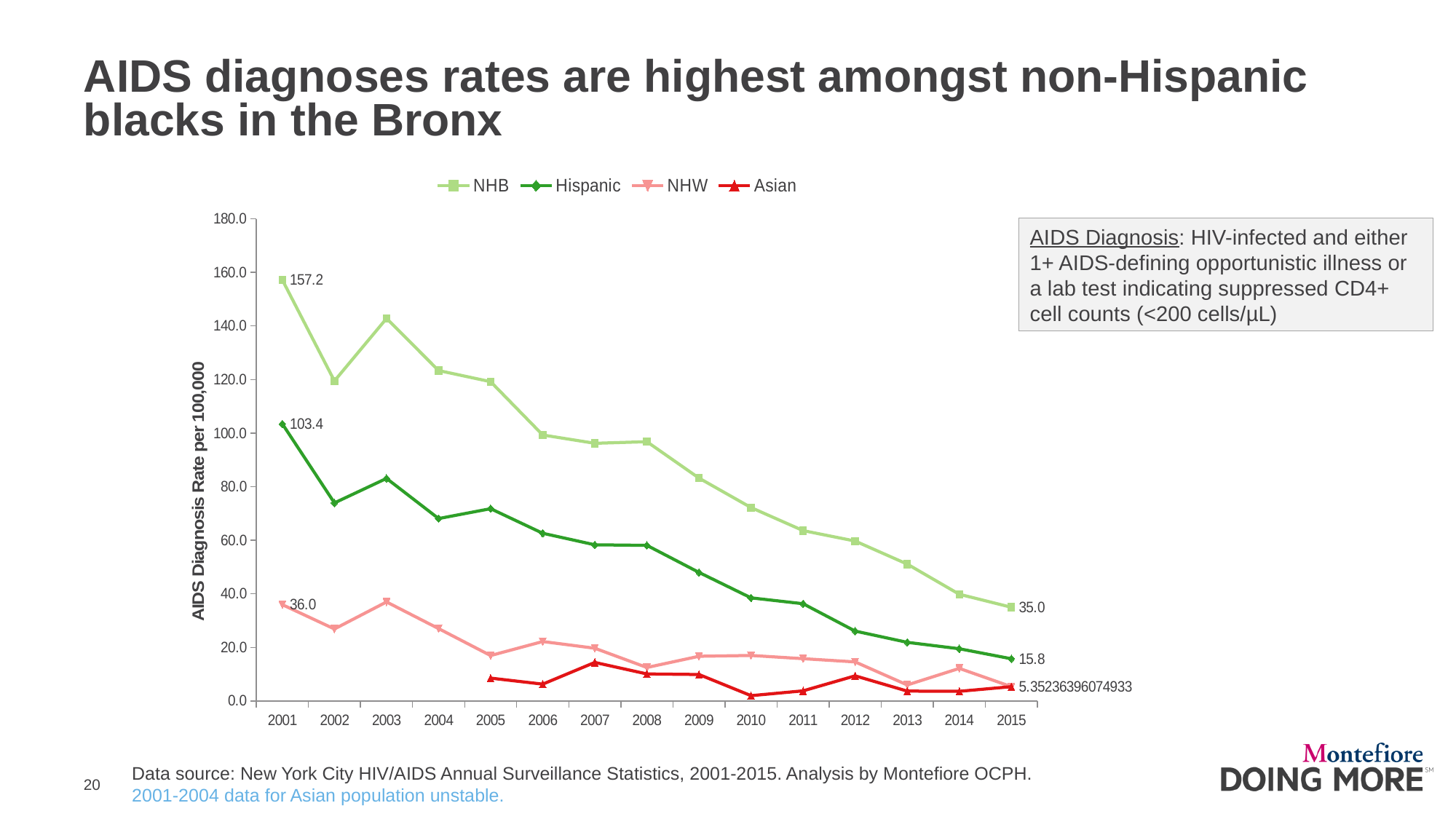
Which series has the highest rate in 2001? NHB How many years are shown on the x axis? 15 Does the NHB rate rise or fall overall from 2001 to 2015? Fall How many series does the legend list? 4 What is the AIDS diagnosis rate for Hispanic in 2001? 103.4 Is the value for NHB in 2003 greater or less than 140.0? greater What is the AIDS diagnosis rate for Hispanic in 2015? 15.8 By how much did the NHB rate fall from 2001 to 2015? 122.2 What type of chart is shown on the slide? Line chart What is the AIDS diagnosis rate for NHB in 2015? 35.0 What is the AIDS diagnosis rate for NHB in 2001? 157.2 What is the AIDS diagnosis rate for NHW in 2001? 36.0